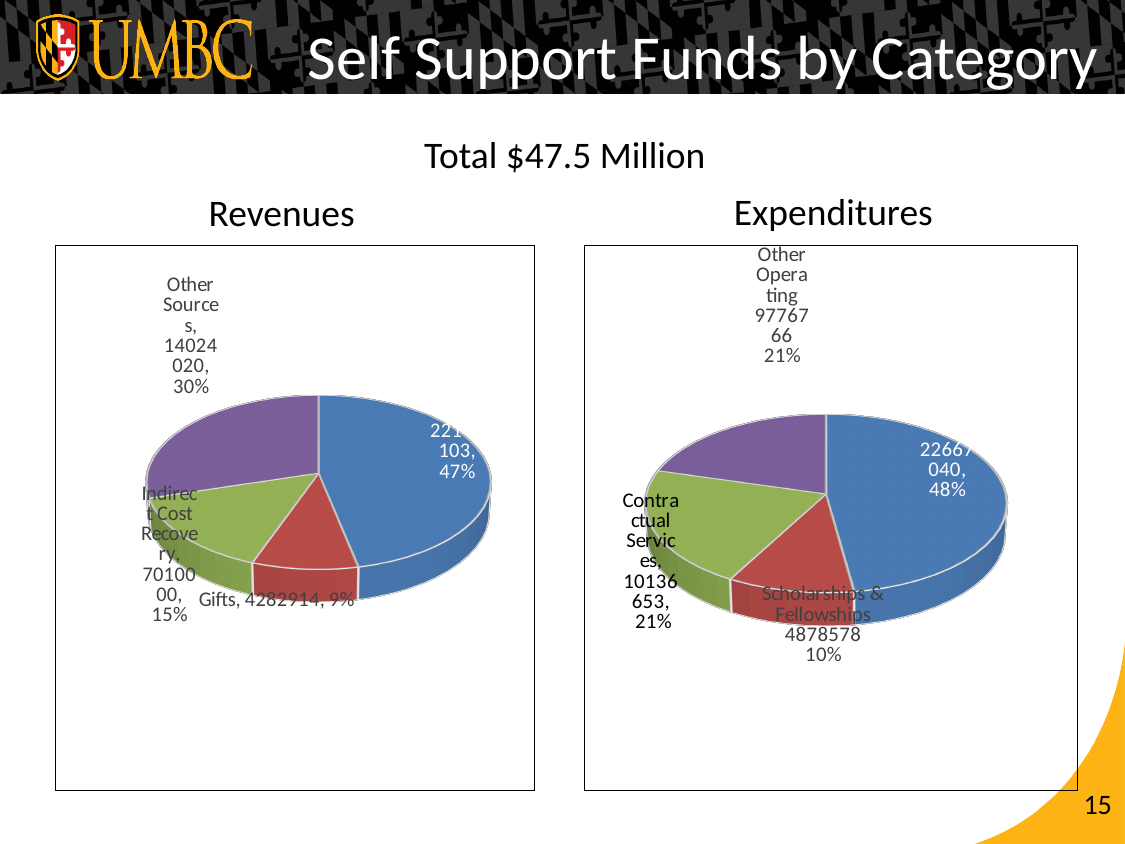
In the Revenues chart, which category has the smallest share? Gifts In the Expenditures chart, what is the value for Other Operating? 9776766 In the Expenditures chart, which is larger, Contractual Services or Scholarships & Fellowships? Contractual Services How many slices does the Revenues pie chart have? 4 In the Expenditures chart, what is the value for Contractual Services? 10136653 In the Revenues chart, what is the value for Gifts? 4282914 What total amount is stated above the two charts? $47.5 Million In the Revenues chart, what is the difference between Indirect Cost Recovery and Gifts? 2727086 In the Expenditures chart, what share of the pie is Scholarships & Fellowships? 10% What kind of chart is the Revenues chart? pie chart In the Revenues chart, what is the value for Indirect Cost Recovery? 7010000 In the Revenues chart, what share of the pie is Other Sources? 30%